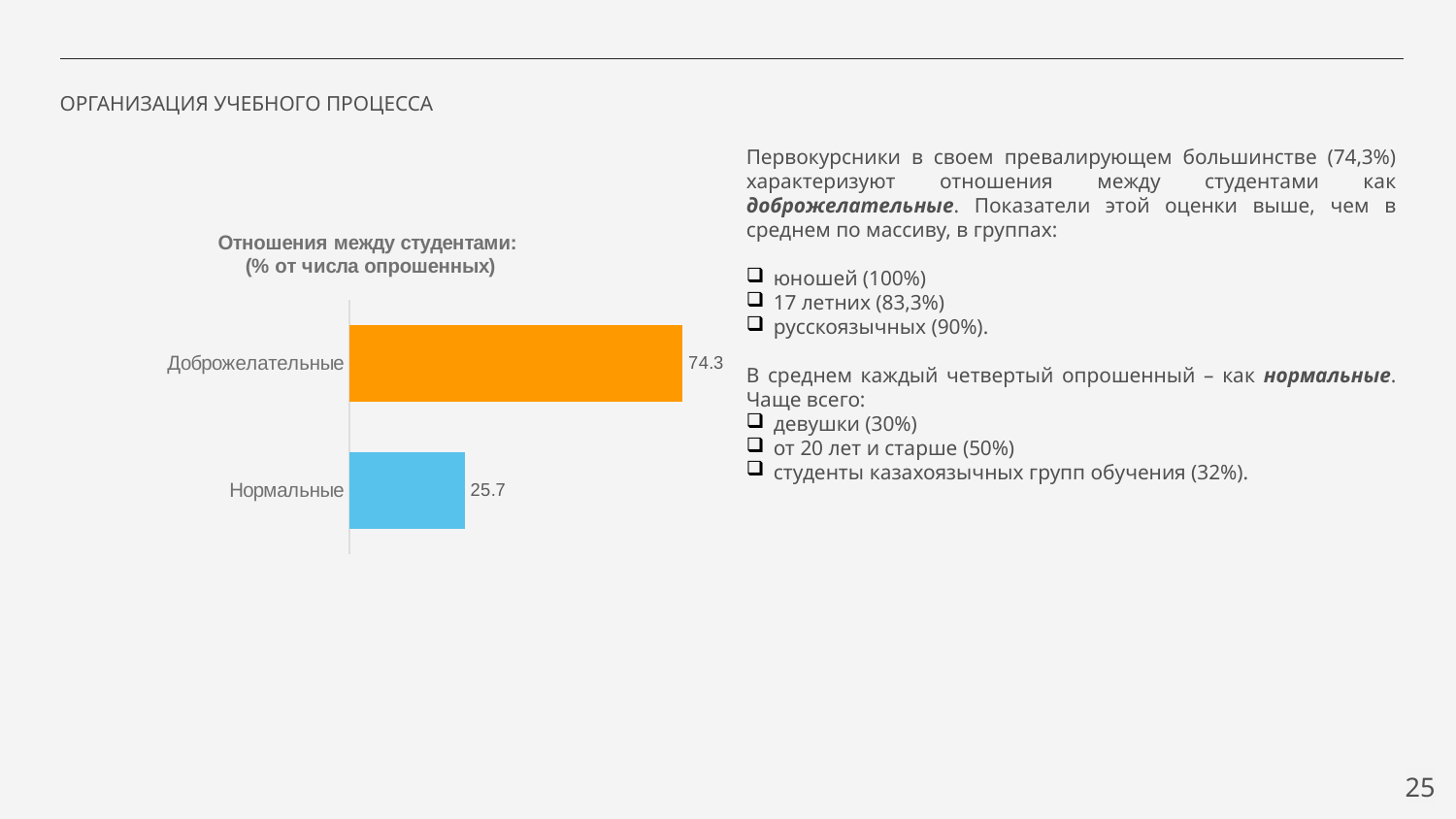
What is the value for Нормальные? 25.7 What is the total of the two values shown in the chart? 100 Which category has the lowest value? Нормальные What colour is the bar for Нормальные? light blue What kind of chart is shown on the slide? bar chart Which category has the highest value? Доброжелательные What is the value for Доброжелательные? 74.3 How many categories are shown in the chart? 2 What is the title of the chart? Отношения между студентами: (% от числа опрошенных) What is the difference between the values for Доброжелательные and Нормальные? 48.6 Which is larger, the value for Доброжелательные or the value for Нормальные? Доброжелательные